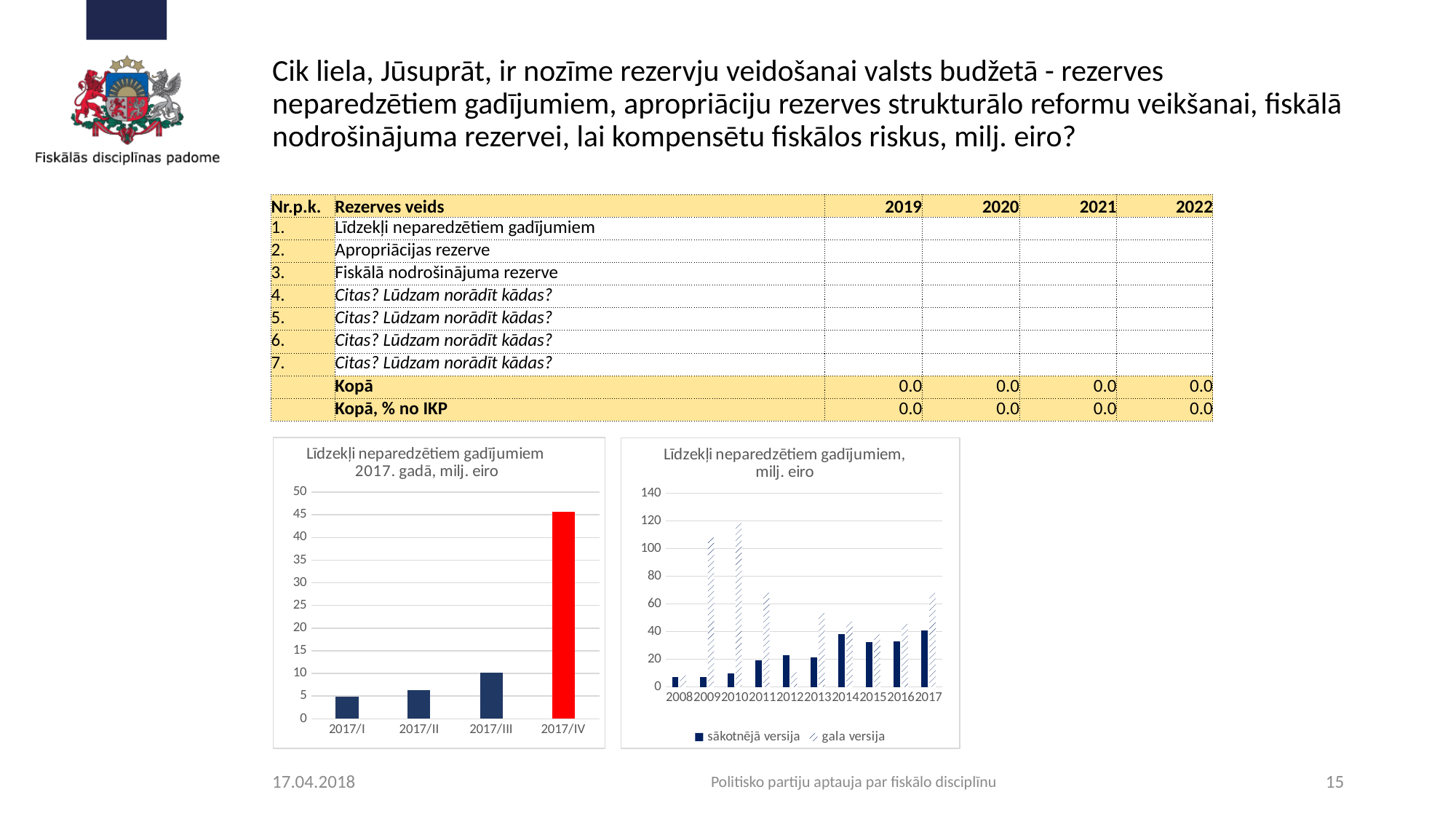
In the right chart (Līdzekļi neparedzētiem gadījumiem, milj. eiro), is the gala versija value for 2010 greater or less than 100? greater In the left chart (2017. gadā), which quarter has the lowest value? 2017/I In the left chart (2017. gadā), do the values rise or fall from 2017/I to 2017/IV? rise In the left chart (2017. gadā), which quarter has the highest value? 2017/IV In the left chart (2017. gadā), is the value for 2017/IV greater or less than 40? greater In the right chart (Līdzekļi neparedzētiem gadījumiem, milj. eiro), which year has the highest value for gala versija? 2010 In the left chart (2017. gadā), is the value for 2017/I greater or less than 10? less In the right chart (Līdzekļi neparedzētiem gadījumiem, milj. eiro), how many years are shown on the x axis? 10 In the left chart (2017. gadā), how many categories are shown on the x axis? 4 What kind of chart is the left chart titled "Līdzekļi neparedzētiem gadījumiem 2017. gadā, milj. eiro"? bar chart In the right chart (Līdzekļi neparedzētiem gadījumiem, milj. eiro), how many series does the legend list? 2 In the left chart (2017. gadā), which bar is coloured red? 2017/IV